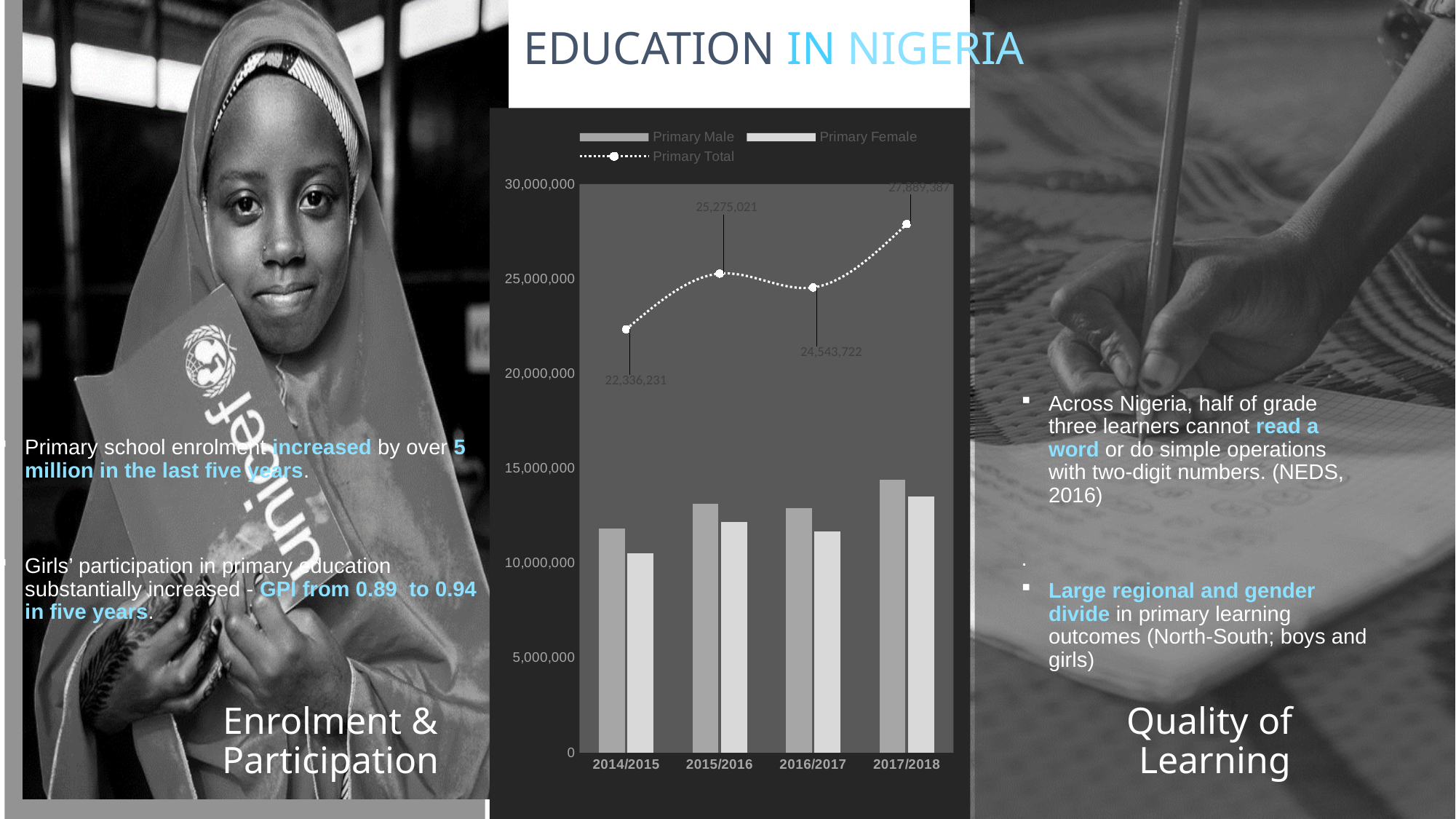
Which is larger, the Primary Total for 2015/2016 or for 2016/2017? 2015/2016 How many series does the legend list? 3 How many school years are shown on the x axis? 4 What is the Primary Total value for 2016/2017? 24,543,722 Does the Primary Total rise or fall from 2015/2016 to 2016/2017? fall Is the Primary Male value for 2017/2018 greater or less than 10,000,000? greater Which year has the highest Primary Total? 2017/2018 What is the Primary Total value for 2017/2018? 27,889,387 What is the Primary Total value for 2014/2015? 22,336,231 What is the difference between the Primary Total for 2017/2018 and 2014/2015? 5,553,156 Which year has the lowest Primary Total? 2014/2015 Is the Primary Female value for 2014/2015 greater or less than 15,000,000? less